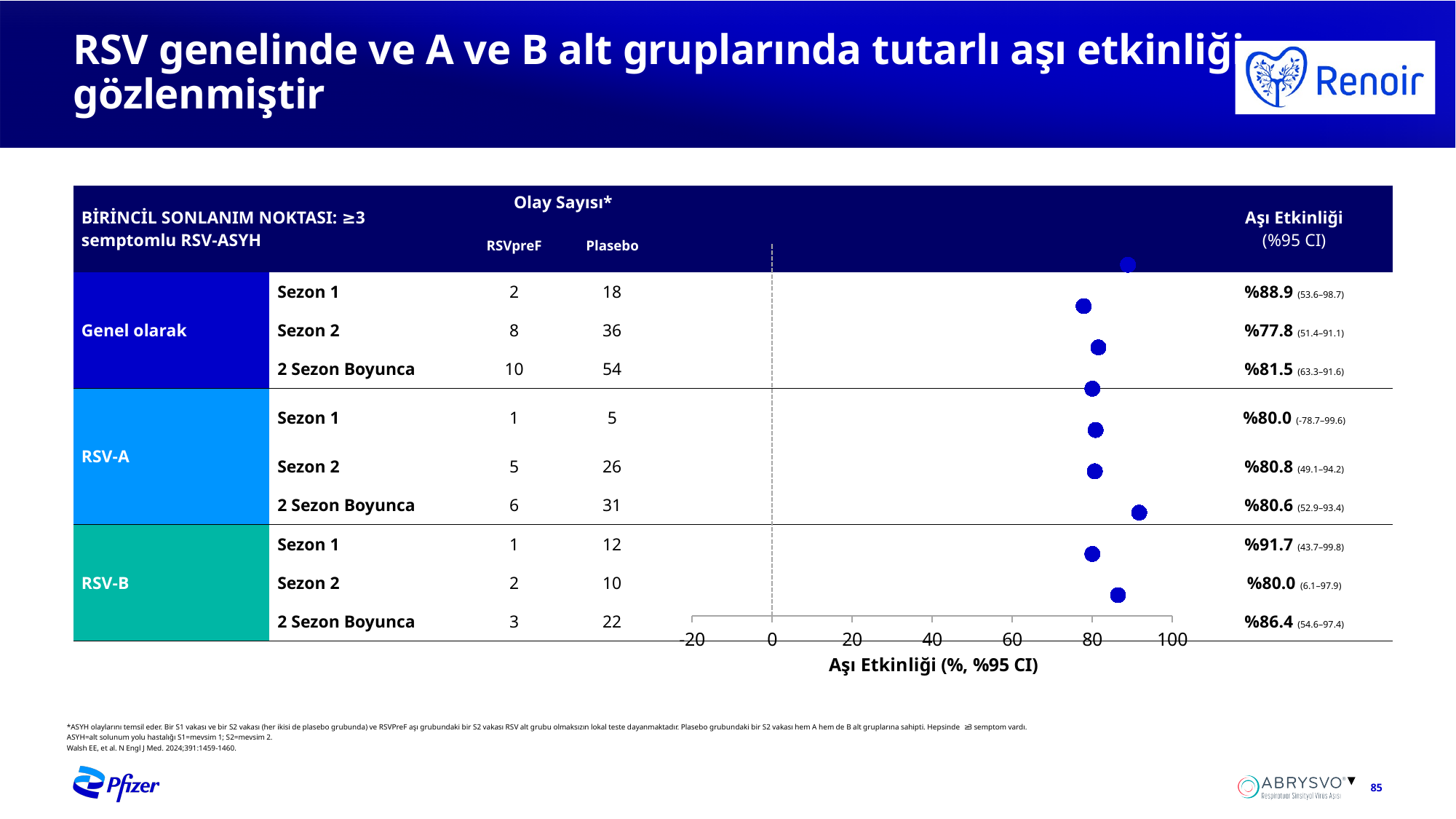
Which row has the highest vaccine efficacy? RSV-B, Sezon 1 (%91.7) What is the x-axis title of the chart? Aşı Etkinliği (%, %95 CI) What kind of chart is used to display the vaccine efficacy values? Dot plot (forest plot) What is the vaccine efficacy for RSV-B, 2 Sezon Boyunca? %86.4 Is the vaccine efficacy for Genel olarak Sezon 2 greater or less than 60? greater How many vaccine efficacy points are plotted in the chart? 9 What are the minimum and maximum tick values on the x axis? -20 and 100 Which row has the lowest vaccine efficacy? Genel olarak, Sezon 2 (%77.8) What is the difference in vaccine efficacy between RSV-B Sezon 1 and Genel olarak Sezon 2? 13.9 percentage points What is the 95% CI shown for RSV-A, Sezon 2? 49.1–94.2 What is the vaccine efficacy (Aşı Etkinliği) for Genel olarak, Sezon 1? %88.9 Which is larger: the vaccine efficacy for RSV-B 2 Sezon Boyunca or for Genel olarak 2 Sezon Boyunca? RSV-B 2 Sezon Boyunca